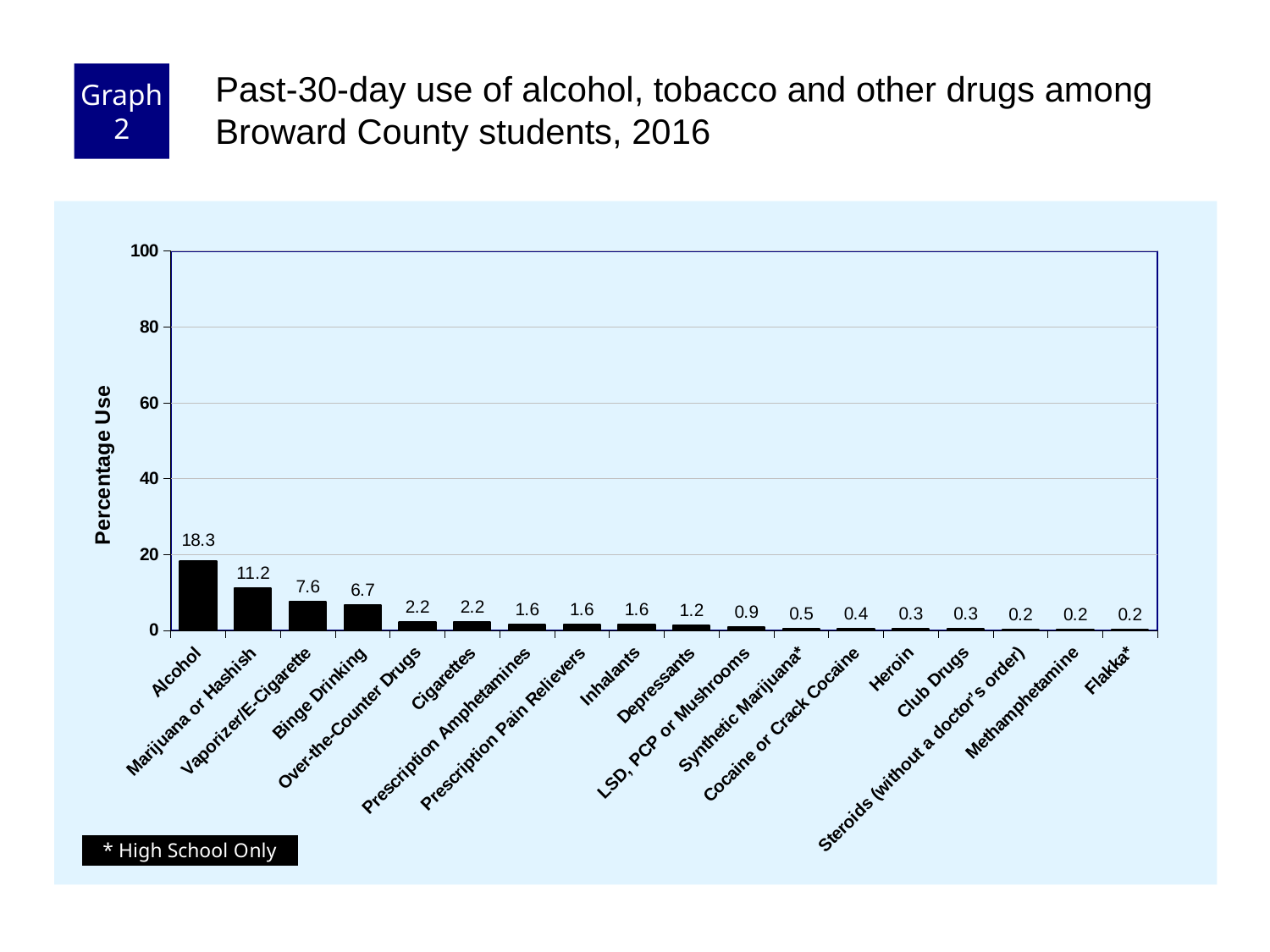
What is the percentage use for Binge Drinking? 6.7 What is the difference in percentage use between Alcohol and Marijuana or Hashish? 7.1 Which has a higher percentage use, Cigarettes or Inhalants? Cigarettes What is the percentage use for Alcohol? 18.3 How many categories are shown on the x axis? 18 What is the difference in percentage use between Vaporizer/E-Cigarette and Binge Drinking? 0.9 What is the percentage use for Heroin? 0.3 Is the value for Alcohol greater or less than 20? less What is the label of the y axis? Percentage Use What kind of chart is shown on the slide? bar chart What is the percentage use for Marijuana or Hashish? 11.2 Which category has the highest percentage use? Alcohol